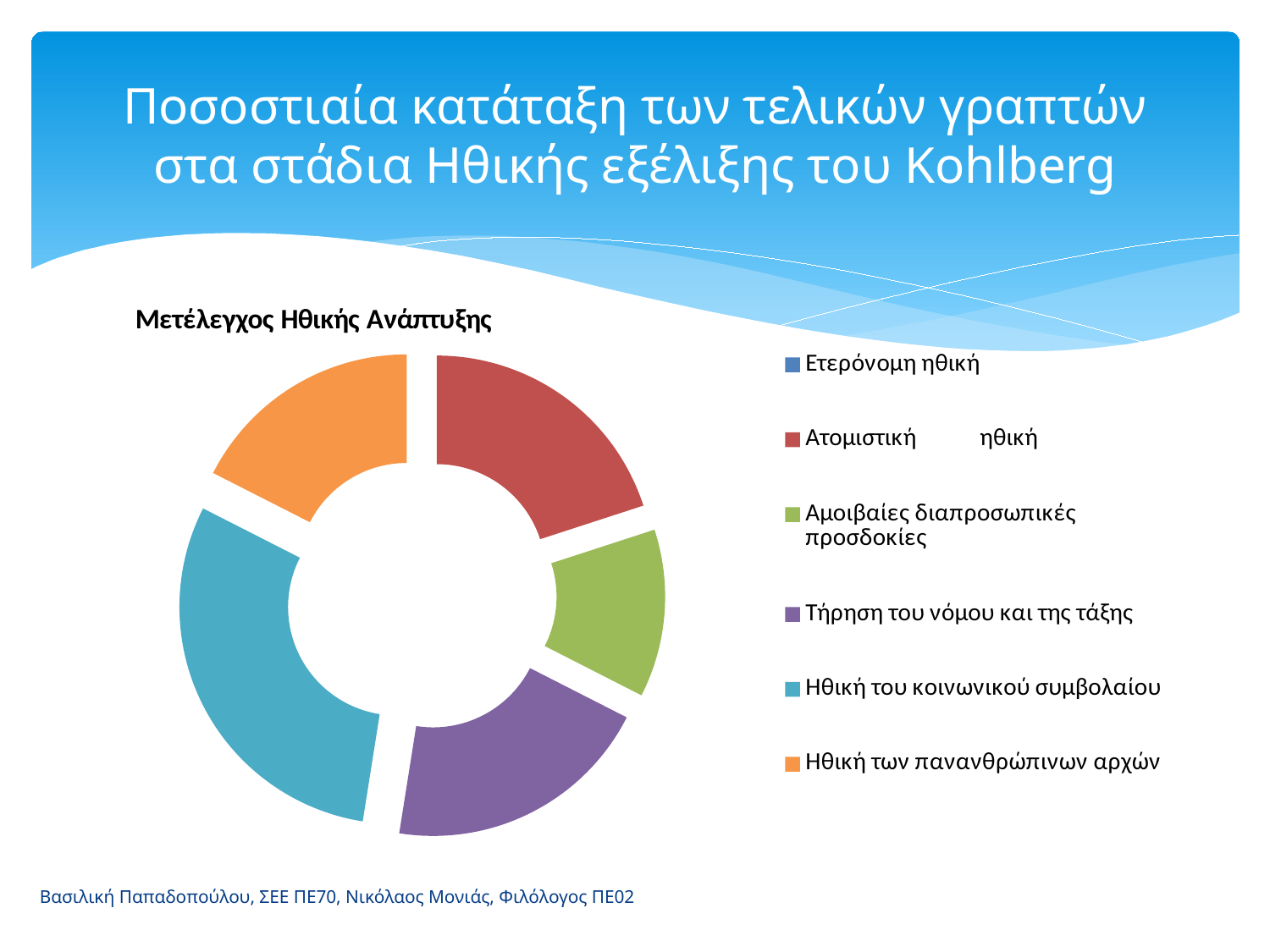
Which colour represents Ηθική των πανανθρώπινων αρχών in the chart? Orange How many entries does the chart's legend list? 6 Which slice is larger: Ατομιστική ηθική or Αμοιβαίες διαπροσωπικές προσδοκίες? Ατομιστική ηθική Which slice is larger: Ηθική του κοινωνικού συμβολαίου or Αμοιβαίες διαπροσωπικές προσδοκίες? Ηθική του κοινωνικού συμβολαίου Which slice is larger: Τήρηση του νόμου και της τάξης or Αμοιβαίες διαπροσωπικές προσδοκίες? Τήρηση του νόμου και της τάξης What kind of chart is shown on the slide? Doughnut (pie) chart Which category has the largest slice in the chart? Ηθική του κοινωνικού συμβολαίου What is the title of the chart? Μετέλεγχος Ηθικής Ανάπτυξης